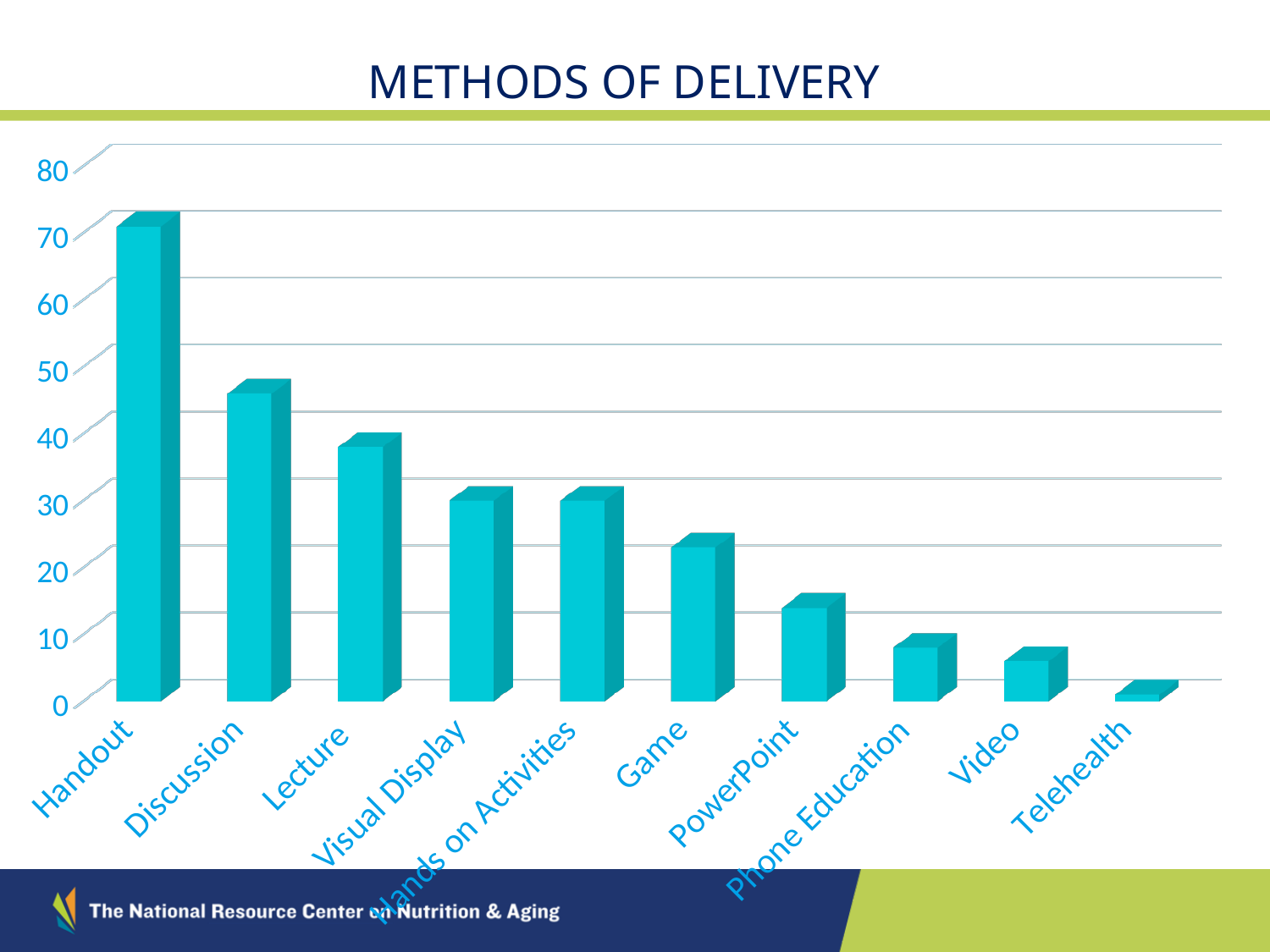
How many delivery methods are shown on the x axis? 10 Is the value for Handout greater or less than 60? greater Which delivery method has the lowest value? Telehealth Which is larger, the value for Game or the value for PowerPoint? Game What is the title of the chart? METHODS OF DELIVERY Which is larger, the value for Handout or the value for Discussion? Handout Is the value for PowerPoint greater or less than 20? less Is the value for Phone Education greater or less than 10? less Do the values rise or fall moving from left to right along the x axis? fall Which delivery method has the highest value? Handout What kind of chart is shown on the slide? bar chart